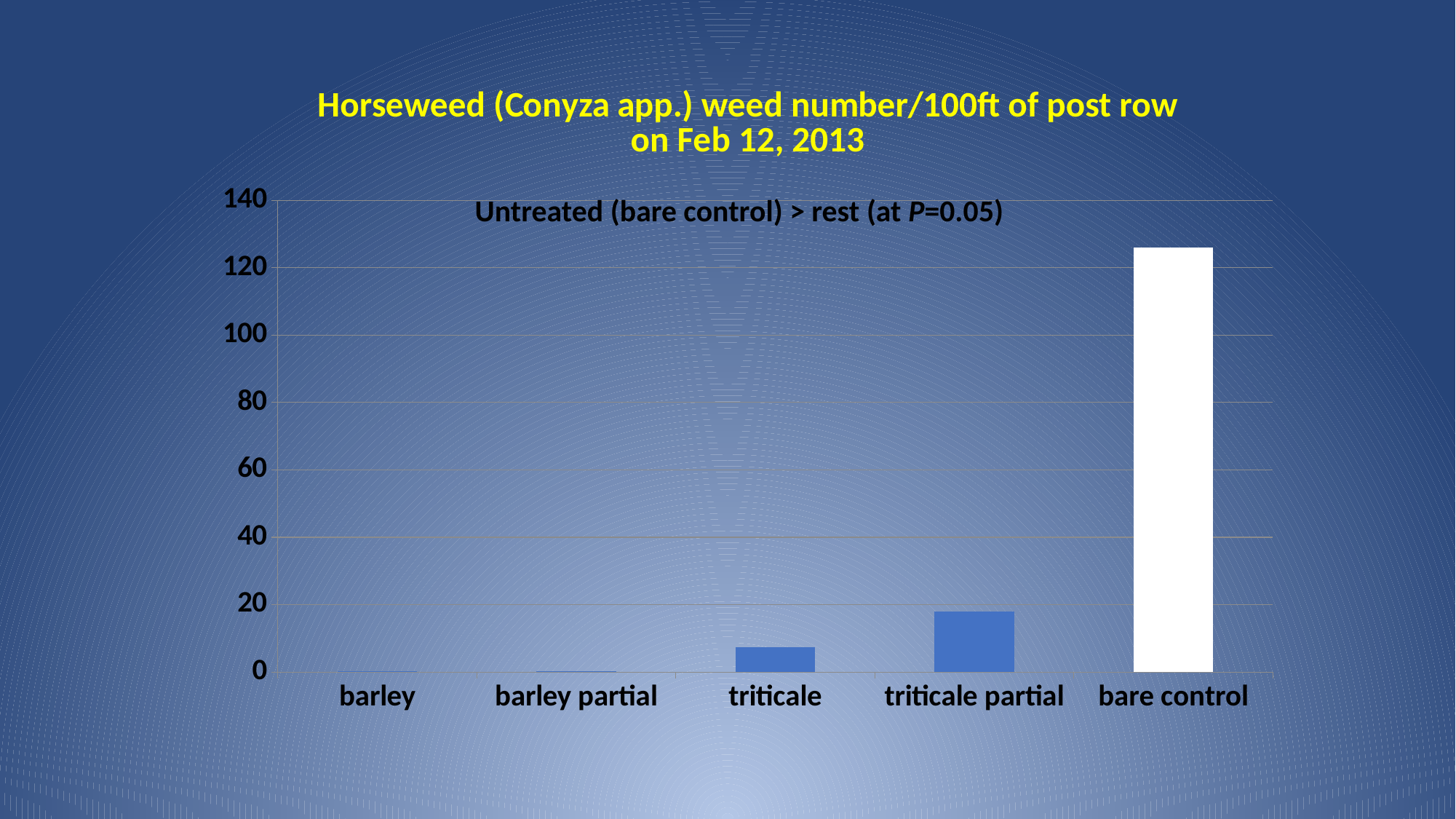
Is the value for bare control greater or less than 100? greater Which has a larger value, triticale or triticale partial? triticale partial What kind of chart is shown on the slide? bar chart What is the highest value shown on the y axis of the chart? 140 Is the value for triticale partial greater or less than 20? less Which category has the highest horseweed number per 100ft of post row? bare control On what date were the horseweed counts in the chart taken, according to the title? Feb 12, 2013 Is the value for triticale greater or less than 20? less Which has a larger value, bare control or triticale partial? bare control How many categories are shown on the x axis of the chart? 5